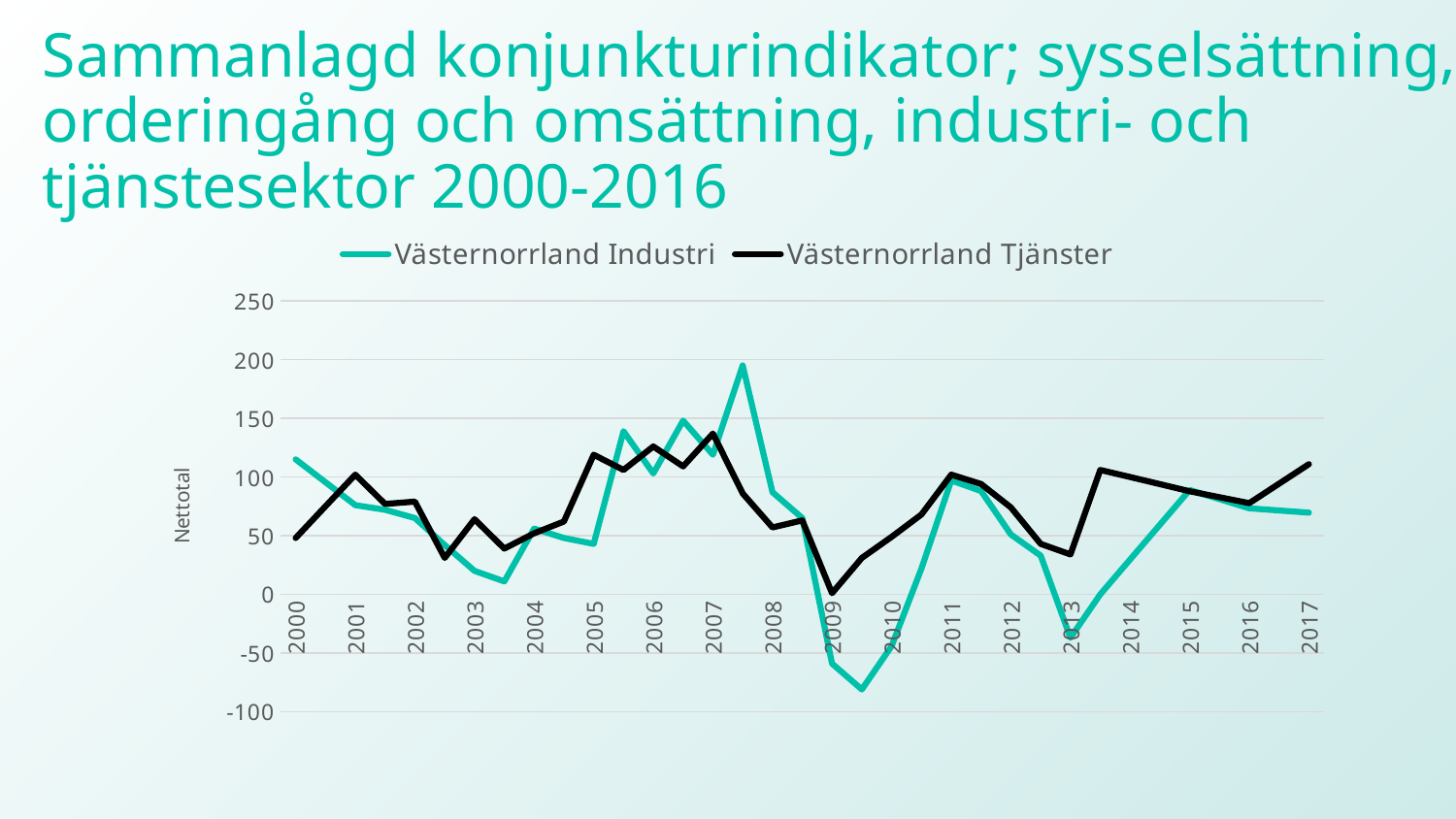
Is the value for Västernorrland Industri in 2000 greater or less than 100? greater How many year labels are shown on the x axis? 18 Is the value for Västernorrland Industri in 2003 greater or less than 50? less In 2000, which series has the higher value, Västernorrland Industri or Västernorrland Tjänster? Västernorrland Industri How many series does the legend list? 2 What is the label on the vertical axis? Nettotal What type of chart is shown on the slide? line chart Is the value for Västernorrland Tjänster in 2017 greater or less than 100? greater In 2017, which series has the higher value, Västernorrland Industri or Västernorrland Tjänster? Västernorrland Tjänster What are the two series named in the legend? Västernorrland Industri and Västernorrland Tjänster Does the Västernorrland Industri line rise or fall between 2015 and 2017? fall